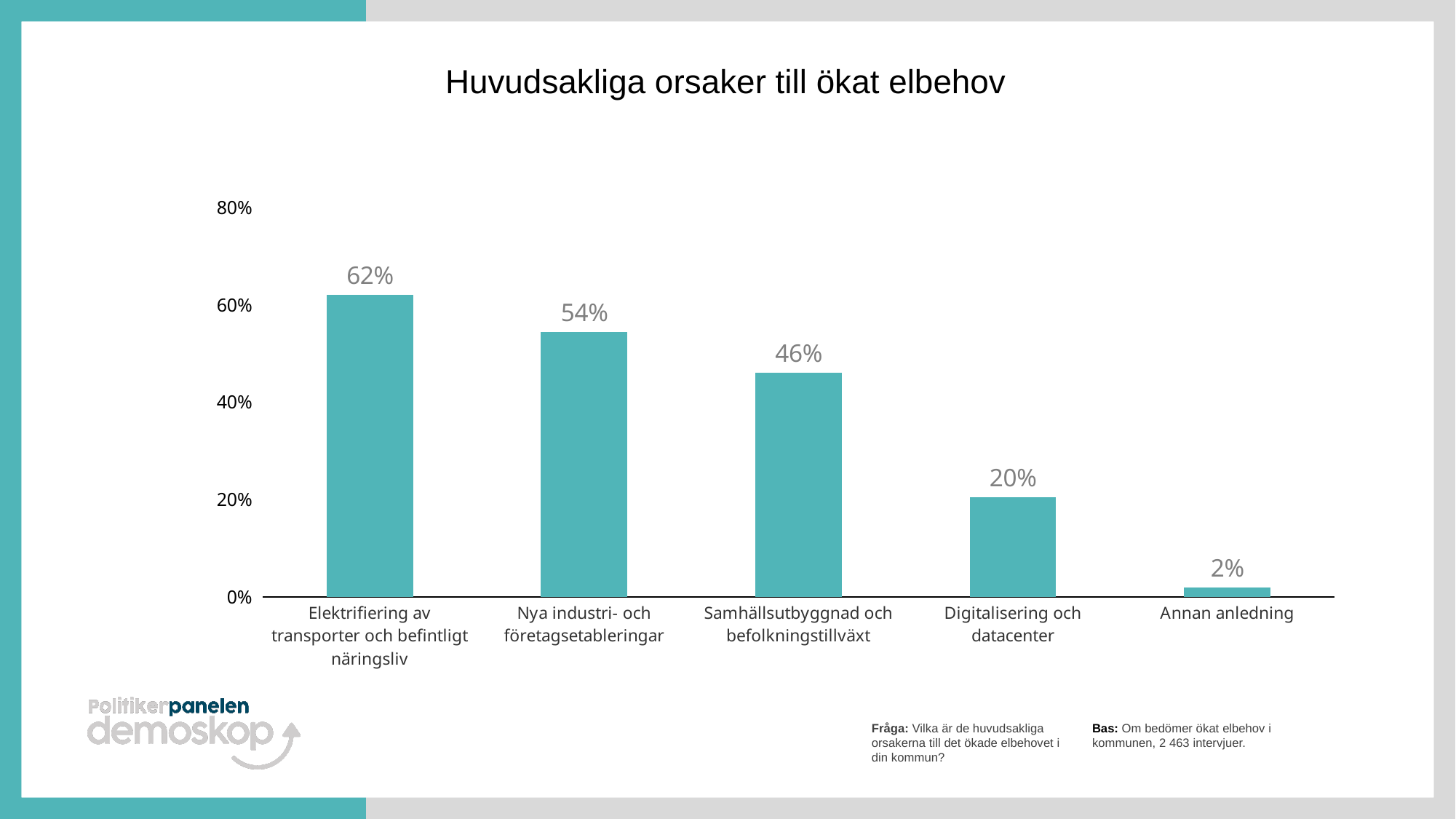
What is the title of the chart? Huvudsakliga orsaker till ökat elbehov What is the value for "Digitalisering och datacenter"? 20% What is the value for "Annan anledning"? 2% What is the value for "Nya industri- och företagsetableringar"? 54% What kind of chart is shown on the slide? bar chart Is the value for "Samhällsutbyggnad och befolkningstillväxt" greater or less than 40%? greater How many categories are shown in the chart? 5 Which category has the lowest value? Annan anledning Do the values rise or fall from left to right along the x axis? fall What is the difference between the values for "Elektrifiering av transporter och befintligt näringsliv" and "Samhällsutbyggnad och befolkningstillväxt"? 16% Which category has the highest value? Elektrifiering av transporter och befintligt näringsliv Which is larger: the value for "Nya industri- och företagsetableringar" or "Samhällsutbyggnad och befolkningstillväxt"? Nya industri- och företagsetableringar